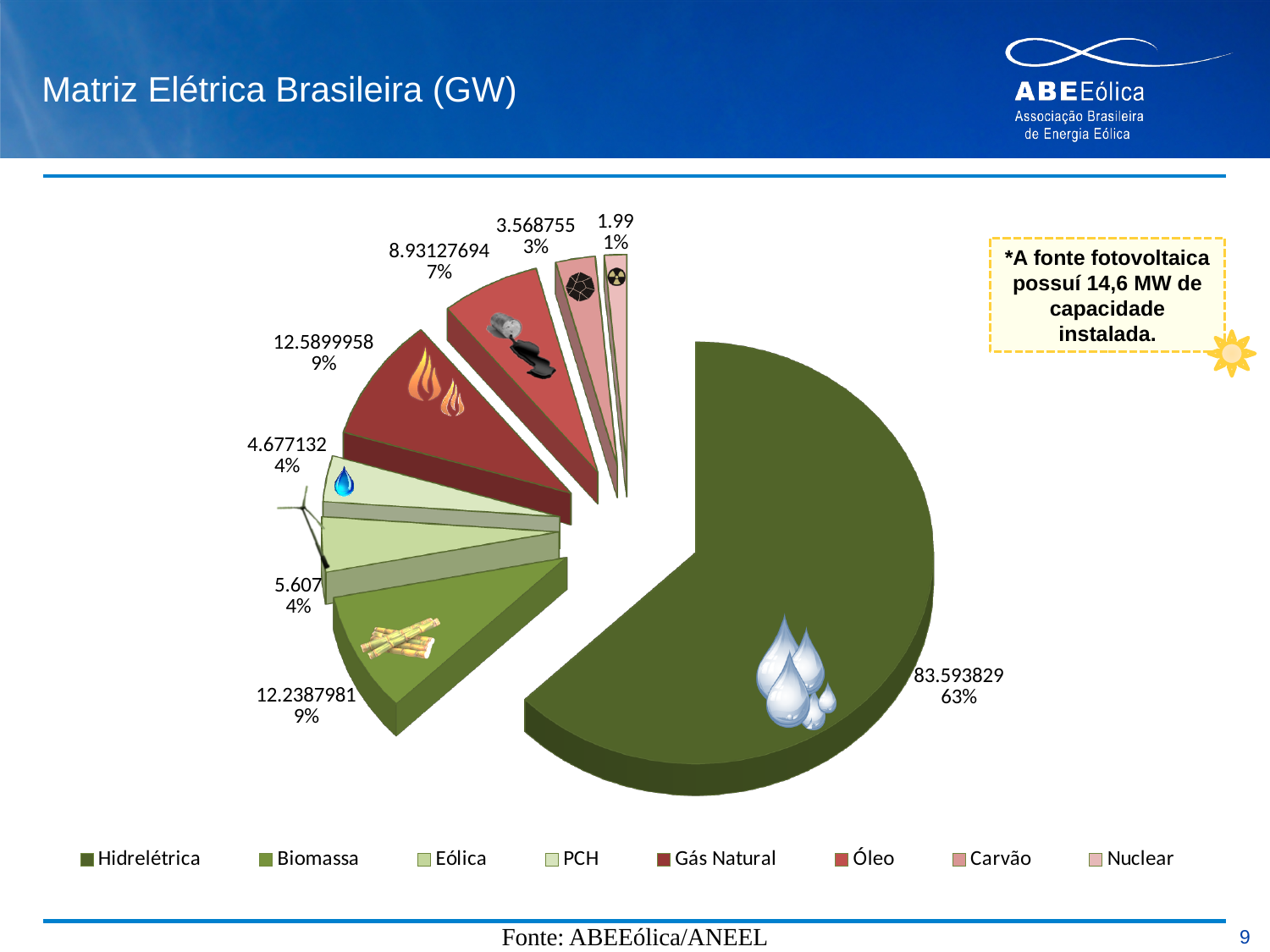
What share of the pie does Carvão represent? 3% Which is larger, the value for Gás Natural or the value for Biomassa? Gás Natural What is the value shown for Nuclear? 1.99 What share of the pie does Hidrelétrica represent? 63% What type of chart is shown on the slide? Pie chart What is the difference between the values for Carvão and Nuclear? 1.578755 Which category has the smallest slice of the pie? Nuclear How many categories does the legend list? 8 What is the value shown for Hidrelétrica? 83.593829 What is the value shown for Óleo? 8.93127694 What is the value shown for Gás Natural? 12.5899958 Which category has the largest slice of the pie? Hidrelétrica